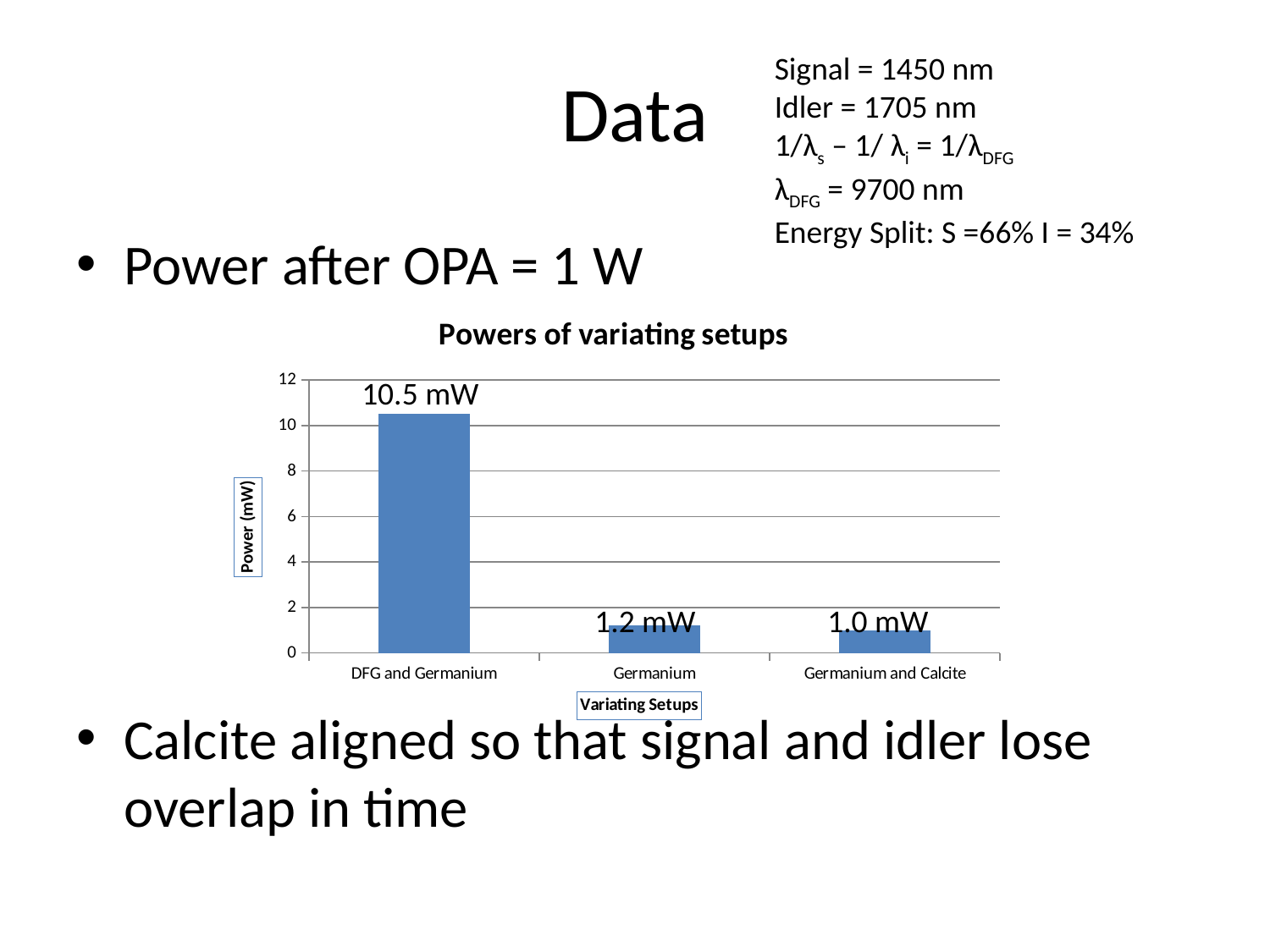
Which setup has the lowest power? Germanium and Calcite What is the difference in power between the DFG and Germanium setup and the Germanium setup? 9.3 mW What is the title of the chart? Powers of variating setups Which setup has the highest power? DFG and Germanium What is the power for the Germanium and Calcite setup? 1.0 mW What is the difference in power between the Germanium setup and the Germanium and Calcite setup? 0.2 mW Is the value for DFG and Germanium greater or less than 10? greater What is the power for the DFG and Germanium setup? 10.5 mW What is the power for the Germanium setup? 1.2 mW Which has a higher power, the DFG and Germanium setup or the Germanium and Calcite setup? DFG and Germanium What kind of chart is shown on the slide? bar chart How many setups are shown in the chart? 3